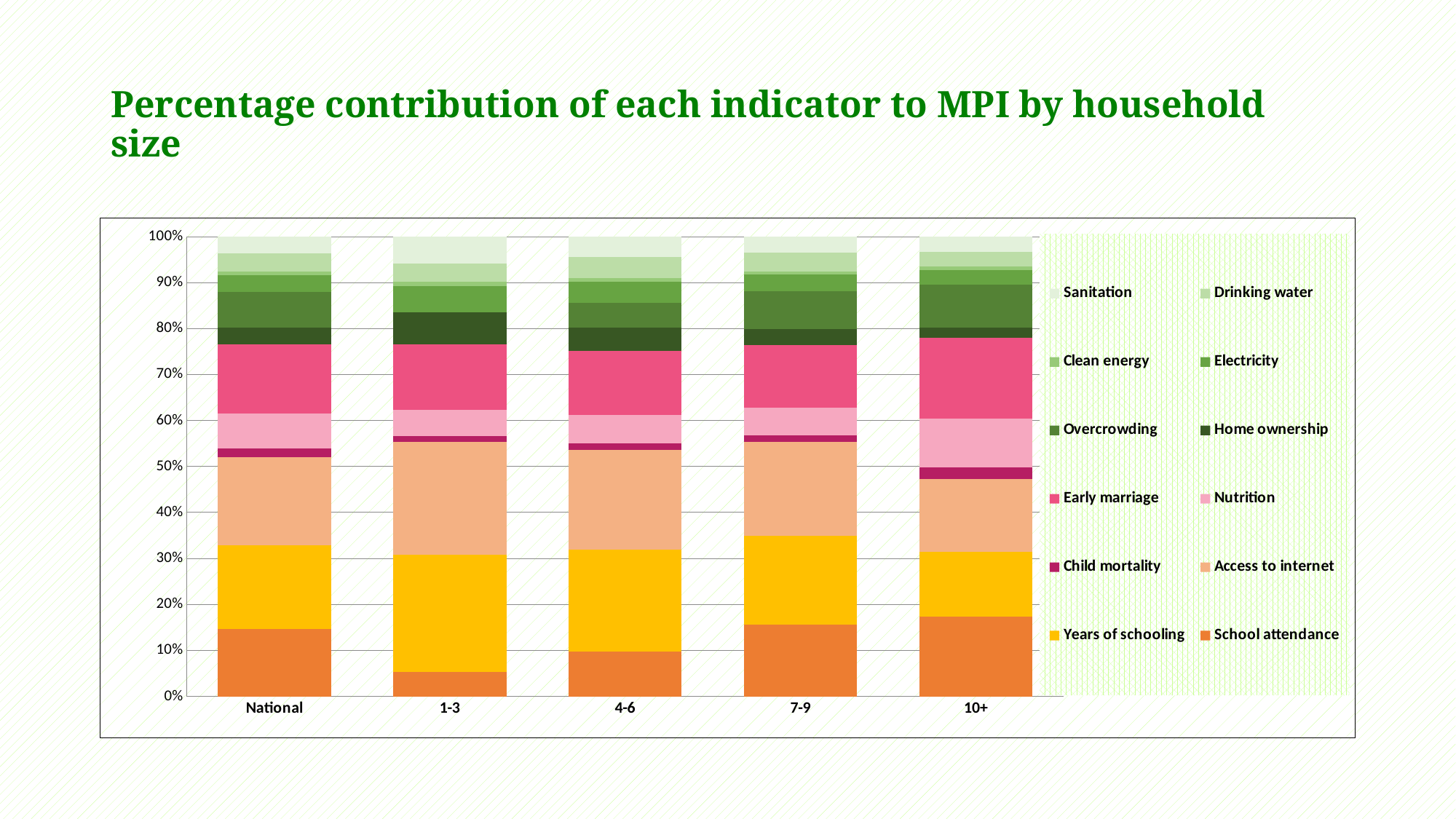
What kind of chart is shown on the slide? Stacked bar chart Which household size category has the smallest School attendance segment? 1-3 What is the title of the slide? Percentage contribution of each indicator to MPI by household size Which household size category has the largest Nutrition segment? 10+ Which household size category has the largest Years of schooling segment? 1-3 Is the School attendance value for the 10+ household size greater or less than 10%? greater Is the School attendance value for the 1-3 household size greater or less than 10%? less How many household size categories are shown on the x axis? 5 Which is larger, the School attendance segment for National or for 1-3? National How many indicators does the legend list? 12 Which indicator is shown at the top of each stacked bar? Sanitation Which household size category has the largest Early marriage segment? 10+